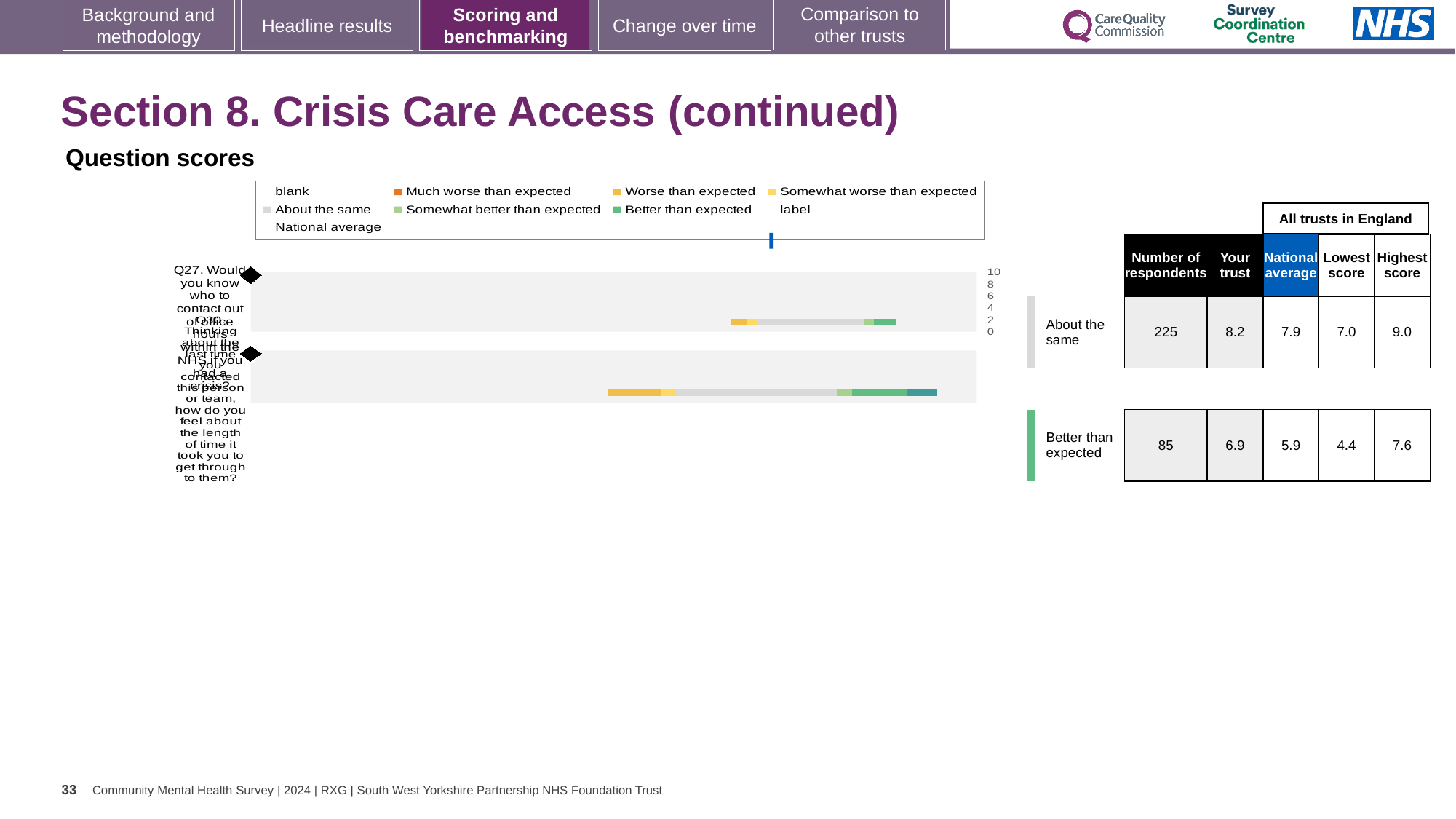
What is the difference between the 'Your trust' score and the national average for Q30? 1.0 What is the national average score for Q30 (how do you feel about the length of time it took you to get through to the person or team)? 5.9 How many questions are plotted in the chart? 2 What is the lowest score among all trusts in England for Q27? 7.0 What benchmark category is shown for Q30? Better than expected What is the difference between the highest and lowest scores for Q27 across all trusts in England? 2.0 How many respondents answered Q27? 225 What is the highest score among all trusts in England for Q30? 7.6 What is the 'Your trust' score for Q27 (Would you know who to contact out of office hours within the NHS if you had a crisis?)? 8.2 Which question has the higher 'Your trust' score, Q27 or Q30? Q27 What kind of chart is used to show the question scores? Bar chart How many respondents answered Q30? 85